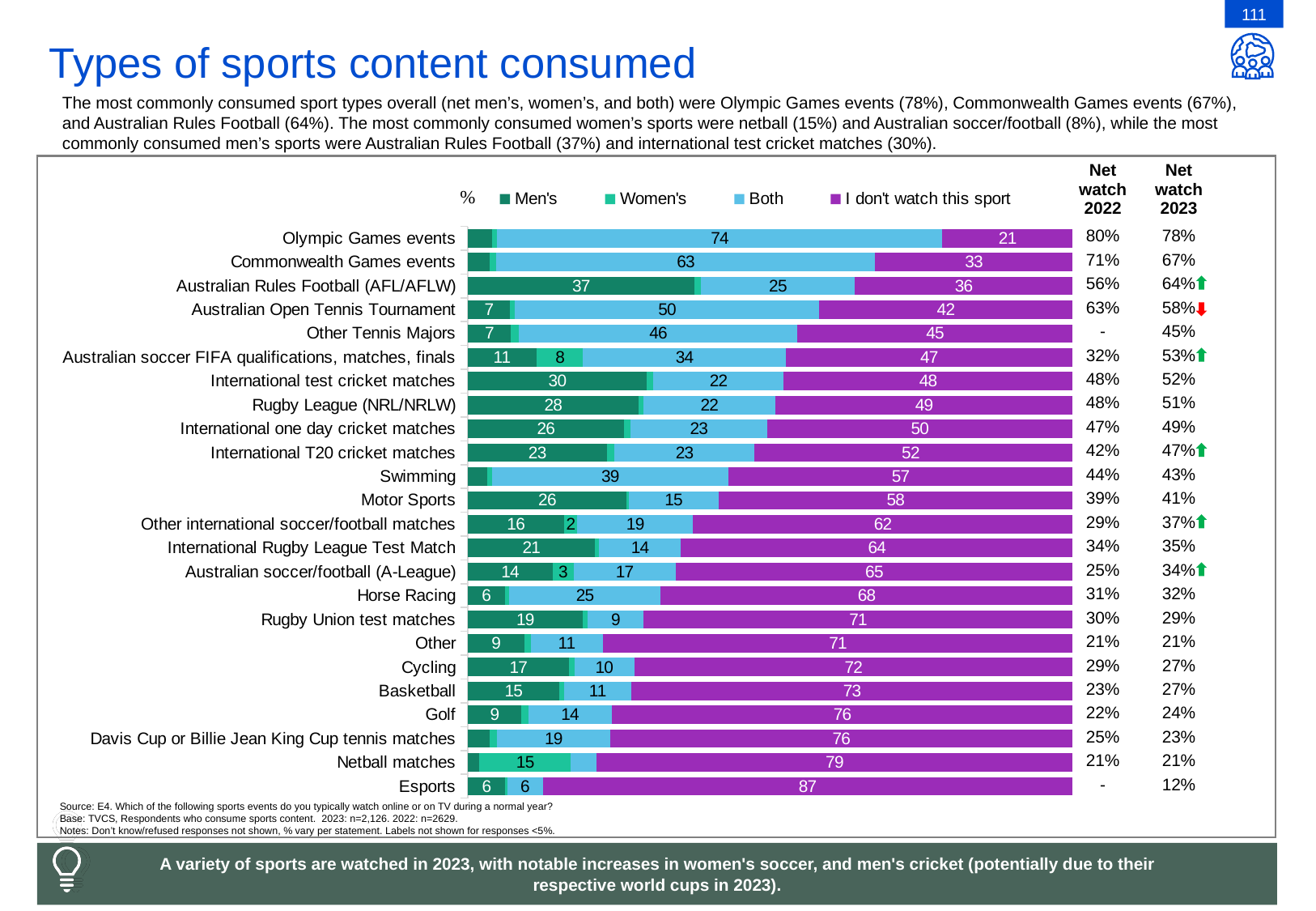
What is the difference between the Men's value for Australian Rules Football (AFL/AFLW) and the Men's value for Rugby League (NRL/NRLW)? 9 What colour represents 'I don't watch this sport' in the legend? Purple Which sport has the highest 'I don't watch this sport' value? Esports What is the Men's value for Australian Rules Football (AFL/AFLW)? 37 Which sport has the lowest 'I don't watch this sport' value? Olympic Games events Which has a larger 'Both' value, Olympic Games events or Commonwealth Games events? Olympic Games events What percentage of respondents said they don't watch Olympic Games events? 21 What is the Women's value for Australian soccer FIFA qualifications, matches, finals? 8 What kind of chart is shown on the slide? Stacked bar chart How many sport categories are shown in the chart? 24 How many series does the legend list? 4 What is the 'Both' value for Commonwealth Games events? 63